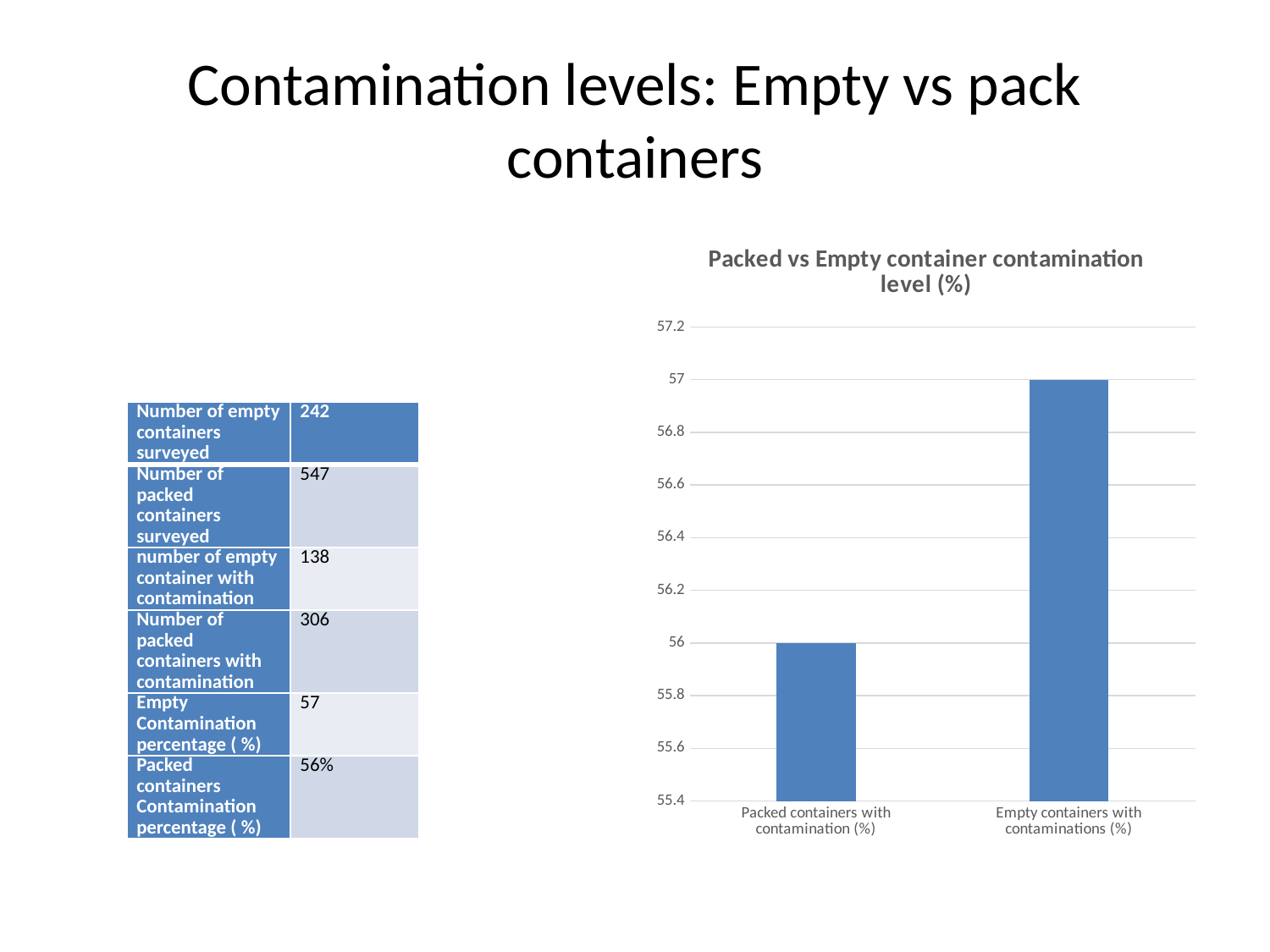
Do the values rise or fall from left to right across the x axis? rise Which category has the lowest contamination level? Packed containers with contamination (%) What is the value for Packed containers with contamination (%)? 56 What kind of chart is shown on the slide? bar chart Which category has the highest contamination level? Empty containers with contaminations (%) What is the difference between the contamination level of empty containers and packed containers? 1 Is the value for Packed containers with contamination (%) greater or less than 56.4? less Which is larger, the value for Packed containers with contamination (%) or Empty containers with contaminations (%)? Empty containers with contaminations (%) What is the value for Empty containers with contaminations (%)? 57 How many bars does the chart show? 2 What is the title of the chart? Packed vs Empty container contamination level (%) Is the value for Empty containers with contaminations (%) greater or less than 56.6? greater